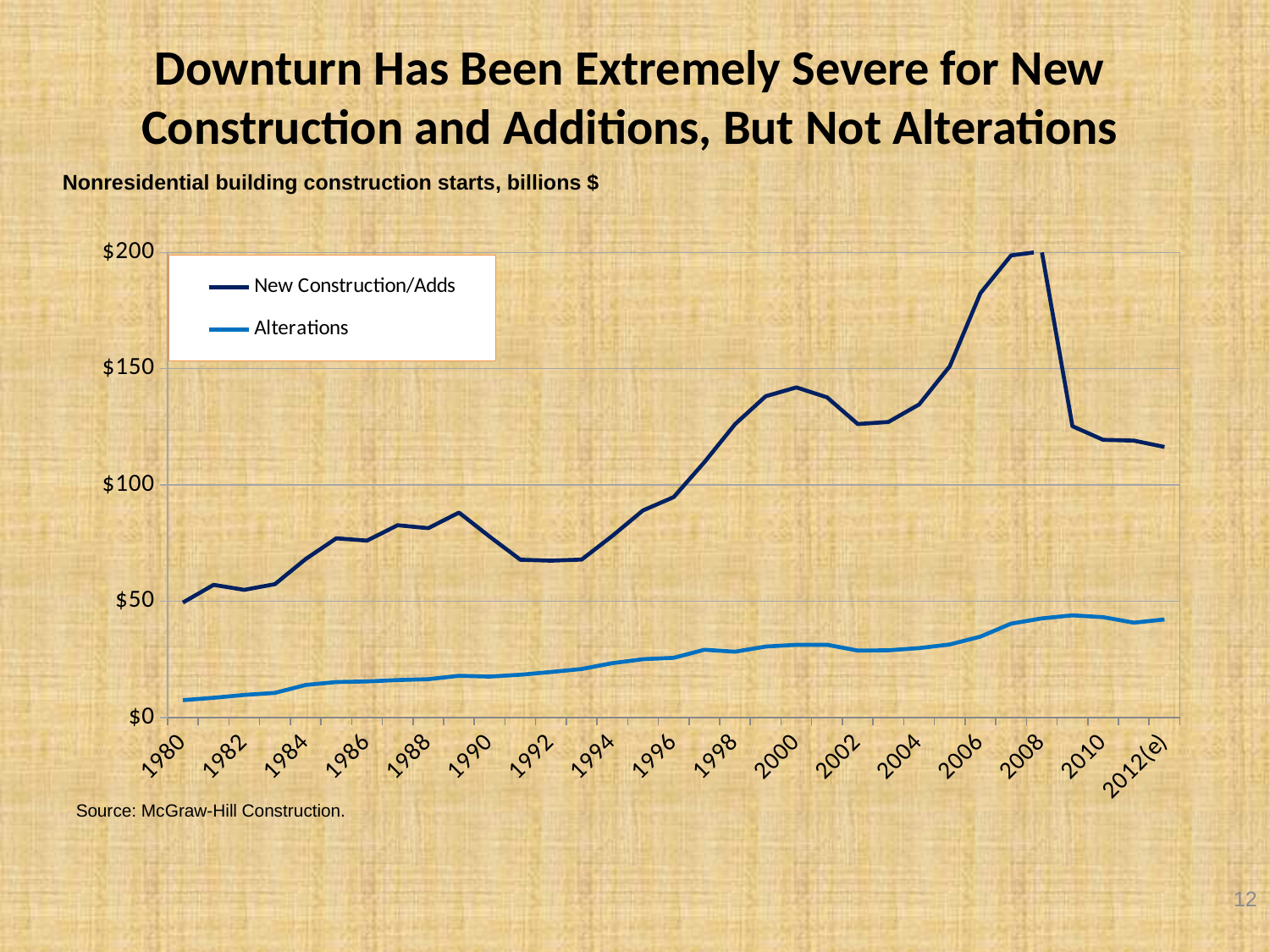
What kind of chart is shown on the slide? line chart Is the value for New Construction/Adds in 2012(e) greater or less than $100? greater What are the two series named in the legend? New Construction/Adds and Alterations Does the New Construction/Adds line rise or fall between 2008 and 2012(e)? fall Is the value for New Construction/Adds in 2006 greater or less than $150? greater How many series does the legend list? 2 Does the Alterations line generally rise or fall from 1980 to 2012(e)? rise Is the value for New Construction/Adds in 1990 greater or less than $100? less In 2000, which series has the larger value, New Construction/Adds or Alterations? New Construction/Adds What unit does the chart subtitle say the values are in? billions $